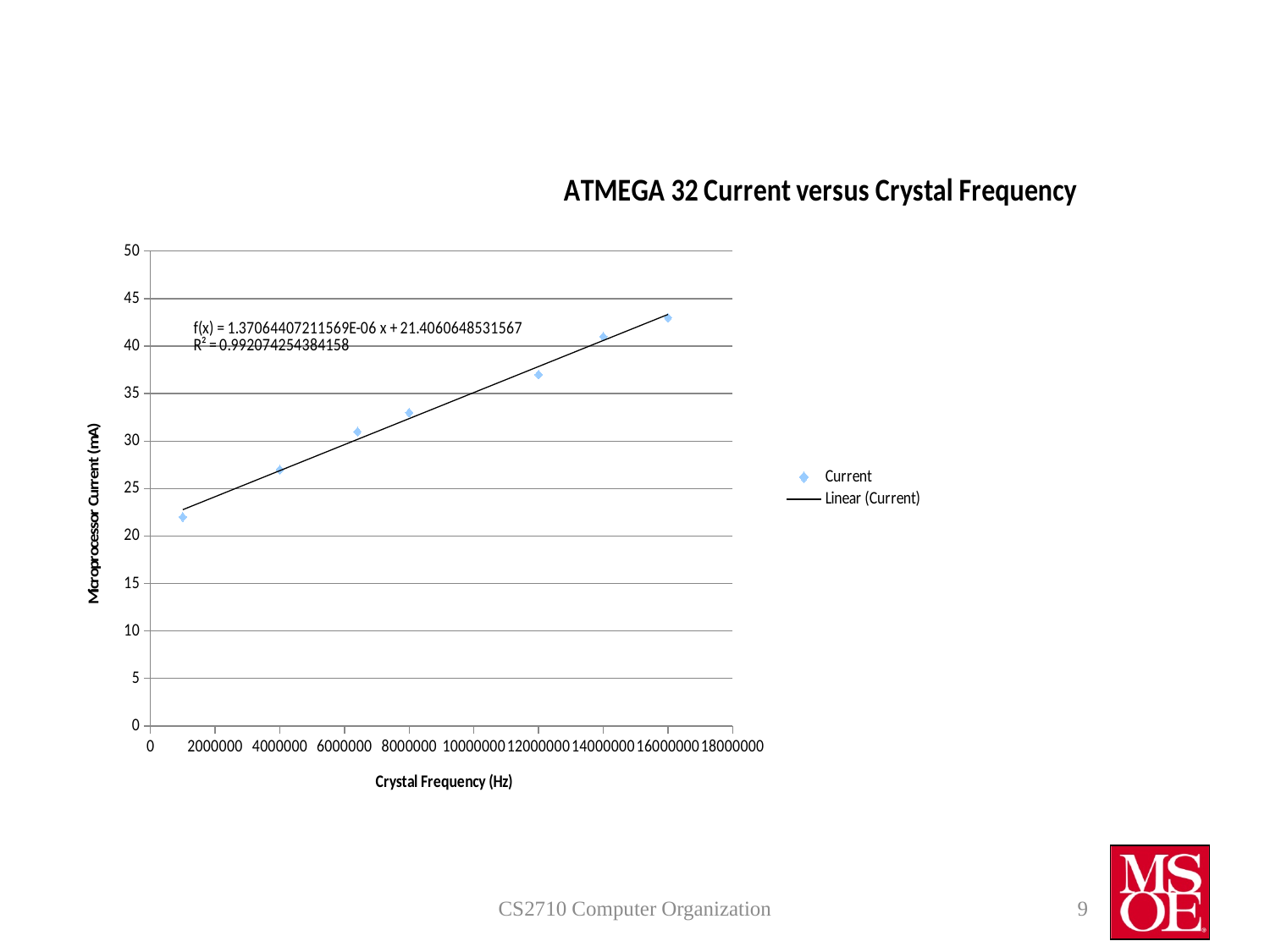
Is the current at the data point near 8000000 Hz greater or less than 30 mA? greater How many data points are plotted for the Current series? 7 Is the current at the lowest-frequency data point greater or less than 25 mA? less What kind of chart is shown on the slide? scatter chart What is the title of the chart? ATMEGA 32 Current versus Crystal Frequency Which data point has the higher current: the one near 4000000 Hz or the one near 8000000 Hz? the one near 8000000 Hz Which data point has the lowest current: the one at the lowest frequency or the one at the highest frequency? the one at the lowest frequency How many entries does the chart's legend list? 2 Is the current at the data point near 12000000 Hz greater or less than 40 mA? less Does the microprocessor current rise or fall as crystal frequency increases? rise What R² value is printed on the chart for the linear fit? 0.992074254384158